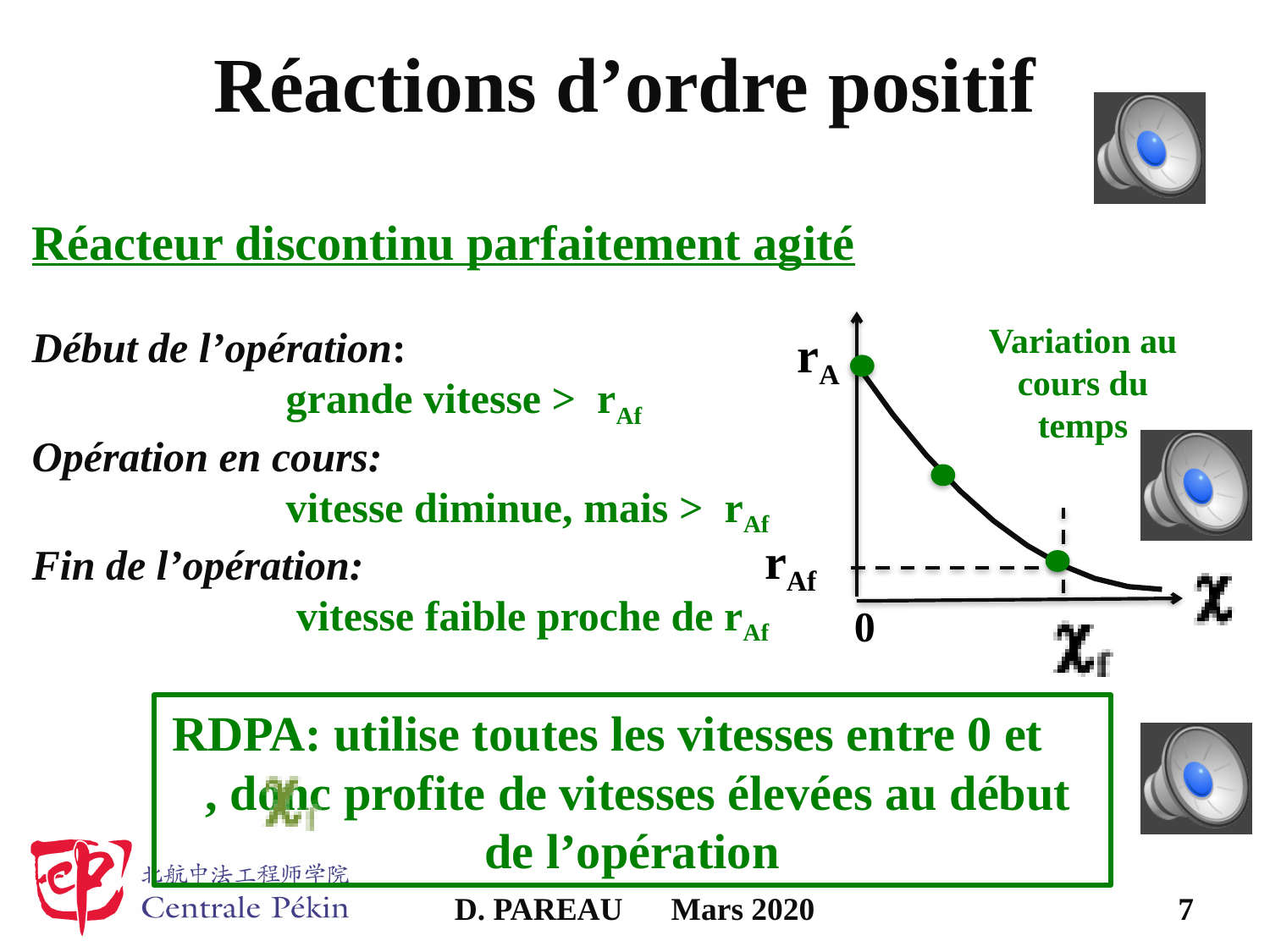
How many points are marked on the curve? 3 At which marked value of χ is the curve lowest? χf What kind of chart is shown on the slide? line chart At which value of χ is the curve highest? 0 What label is given to the value of the curve at χ = 0? rA Does the curve rise or fall as χ increases? fall What value does the curve take at χ = χf, according to the dashed line label? rAf Which is larger, the value of the curve at χ = 0 or at χ = χf? at χ = 0 What is the title of the chart? Variation au cours du temps What label is on the horizontal axis of the chart? χ